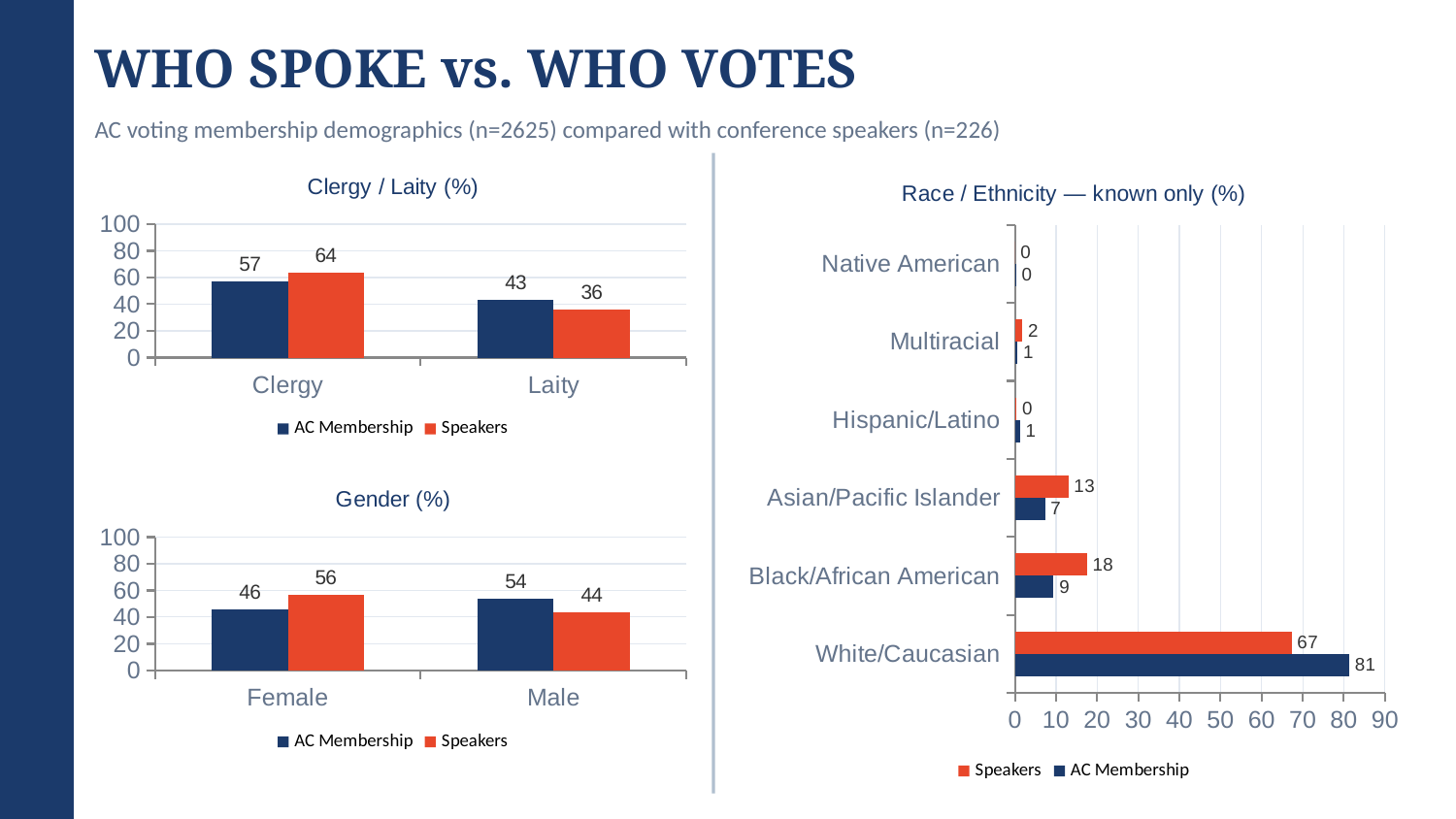
In the Gender (%) chart, which is larger for Male: AC Membership or Speakers? AC Membership In the Clergy / Laity (%) chart, what is the Speakers value for Laity? 36 In the Gender (%) chart, what is the difference between the Speakers and AC Membership values for Female? 10 In the Race / Ethnicity — known only (%) chart, what is the difference between the AC Membership and Speakers values for White/Caucasian? 14 In the Clergy / Laity (%) chart, what is the AC Membership value for Clergy? 57 In the Clergy / Laity (%) chart, what is the difference between the Speakers and AC Membership values for Clergy? 7 In the Race / Ethnicity — known only (%) chart, which category has the highest Speakers value? White/Caucasian What type of chart is the Race / Ethnicity — known only (%) chart? Bar chart In the Race / Ethnicity — known only (%) chart, how many race/ethnicity categories are shown? 6 In the Race / Ethnicity — known only (%) chart, what is the Speakers value for Black/African American? 18 In the Race / Ethnicity — known only (%) chart, what is the AC Membership value for White/Caucasian? 81 In the Gender (%) chart, what is the Speakers value for Female? 56